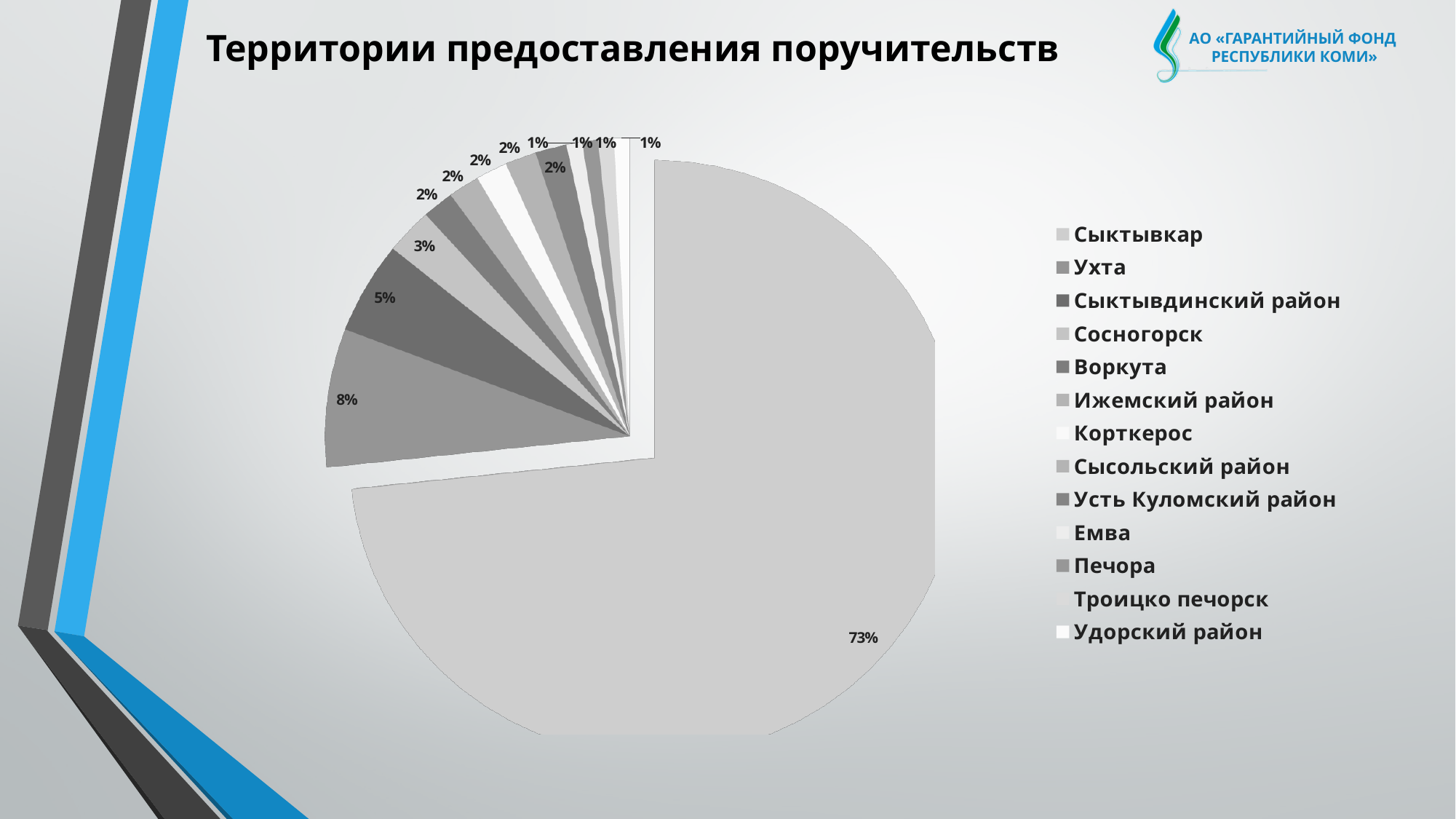
Which has the larger share, Сыктывдинский район or Сосногорск? Сыктывдинский район What share of the pie does Сыктывдинский район have? 5% What is the title of the chart on the slide? Территории предоставления поручительств What share of the pie does Ухта have? 8% What share of the pie does Сыктывкар have? 73% What kind of chart is shown on the slide? pie chart Which territory has the largest slice of the pie? Сыктывкар How many territories are listed in the legend? 13 What is the difference in percentage points between the shares of Сыктывкар and Ухта? 65 percentage points Which has the larger share, Ухта or Сосногорск? Ухта What share of the pie does Сосногорск have? 3% What is the last entry listed in the legend? Удорский район